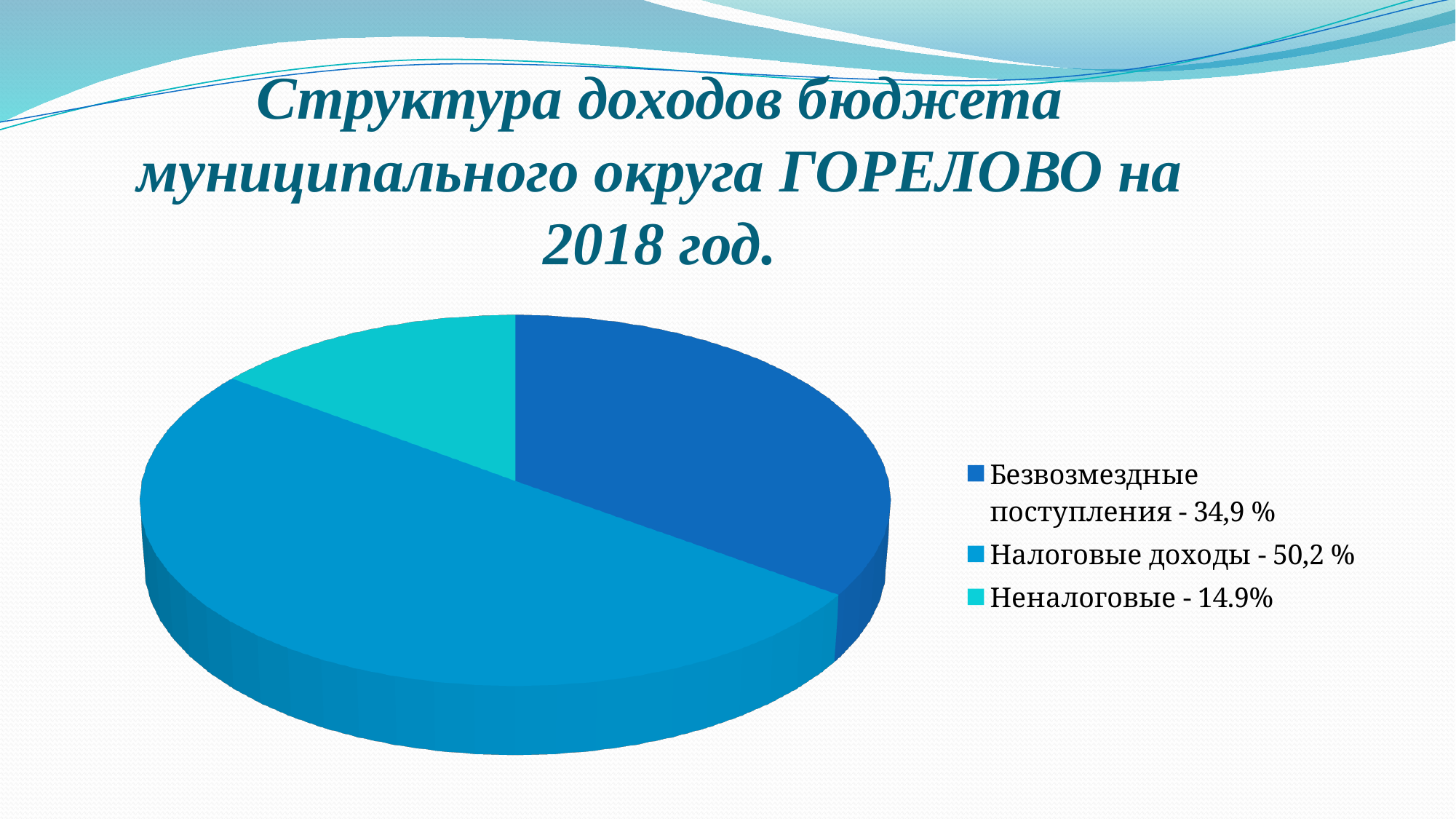
How many slices does the pie chart have? 3 Which category is shown in the darkest blue colour on the pie chart? Безвозмездные поступления By how many percentage points does the share of Безвозмездные поступления exceed the share of Неналоговые? 20 Which category has the smallest share of the pie? Неналоговые What share of budget revenue is shown for Неналоговые? 14.9% By how many percentage points does the share of Налоговые доходы exceed the share of Безвозмездные поступления? 15,3 What kind of chart is shown on the slide? Pie chart Which category has the largest share of the pie? Налоговые доходы Which is larger: the share for Безвозмездные поступления or the share for Неналоговые? Безвозмездные поступления What share of budget revenue is shown for Безвозмездные поступления? 34,9 % What share of budget revenue is shown for Налоговые доходы? 50,2 % How many entries does the legend list? 3